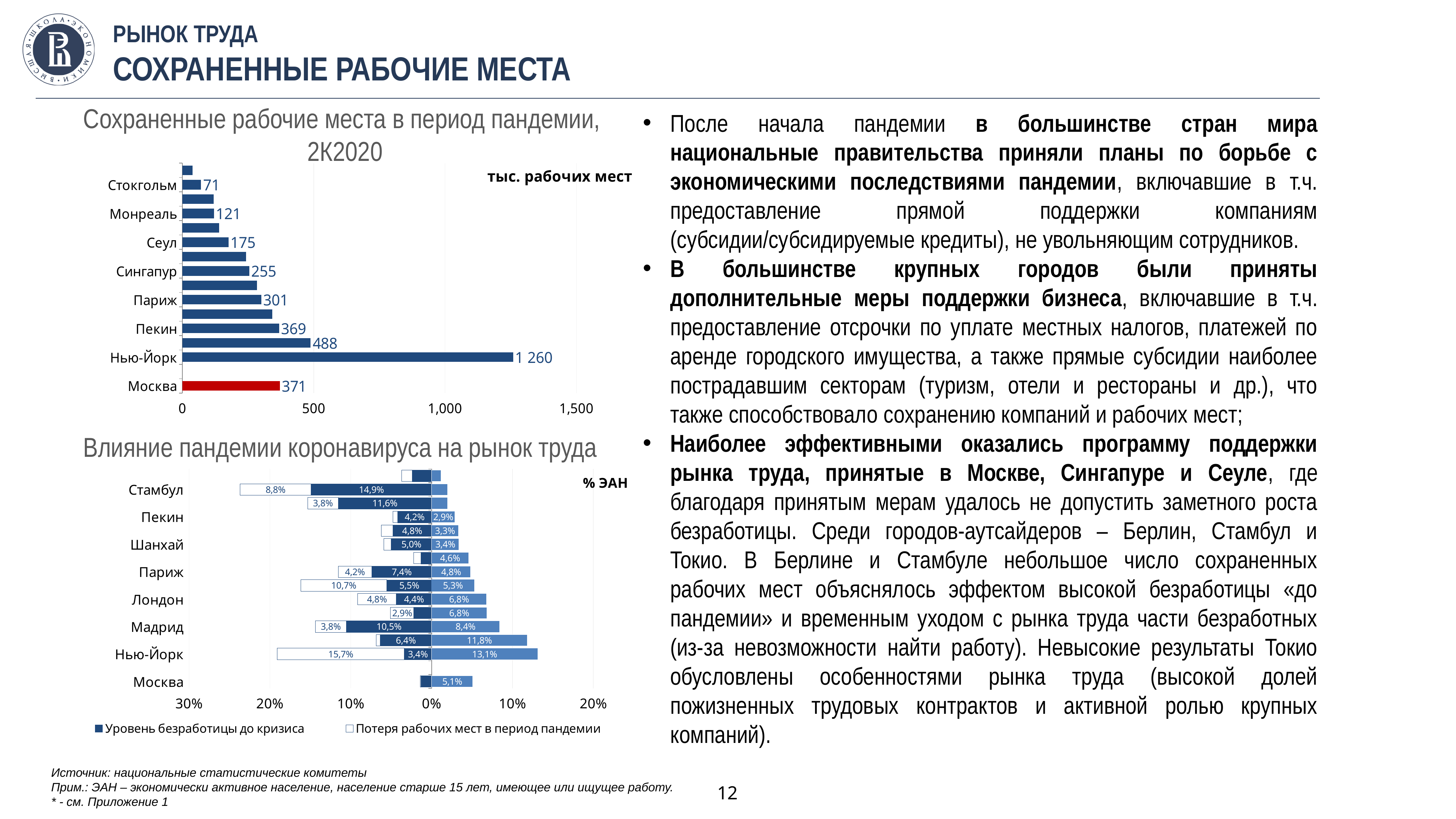
In the chart 'Сохраненные рабочие места в период пандемии, 2К2020', what is the difference between the values for Москва and Пекин? 2 In the chart 'Сохраненные рабочие места в период пандемии, 2К2020', is the value for Пекин greater or less than 500? less In the chart 'Сохраненные рабочие места в период пандемии, 2К2020', what is the value for Нью-Йорк? 1 260 In the chart 'Сохраненные рабочие места в период пандемии, 2К2020', what is the value for Москва? 371 What kind of chart is 'Сохраненные рабочие места в период пандемии, 2К2020'? bar chart In the chart 'Сохраненные рабочие места в период пандемии, 2К2020', which city has the highest value? Нью-Йорк In the chart 'Влияние пандемии коронавируса на рынок труда', what is the value printed on the bar for Москва? 5,1% In the chart 'Сохраненные рабочие места в период пандемии, 2К2020', what is the value for Сингапур? 255 How many series does the legend of the chart 'Влияние пандемии коронавируса на рынок труда' list? 2 In the chart 'Сохраненные рабочие места в период пандемии, 2К2020', which is larger: the value for Париж or for Сеул? Париж In the chart 'Сохраненные рабочие места в период пандемии, 2К2020', which city has the lowest labeled value? Стокгольм In the chart 'Сохраненные рабочие места в период пандемии, 2К2020', what unit is shown for the values? тыс. рабочих мест